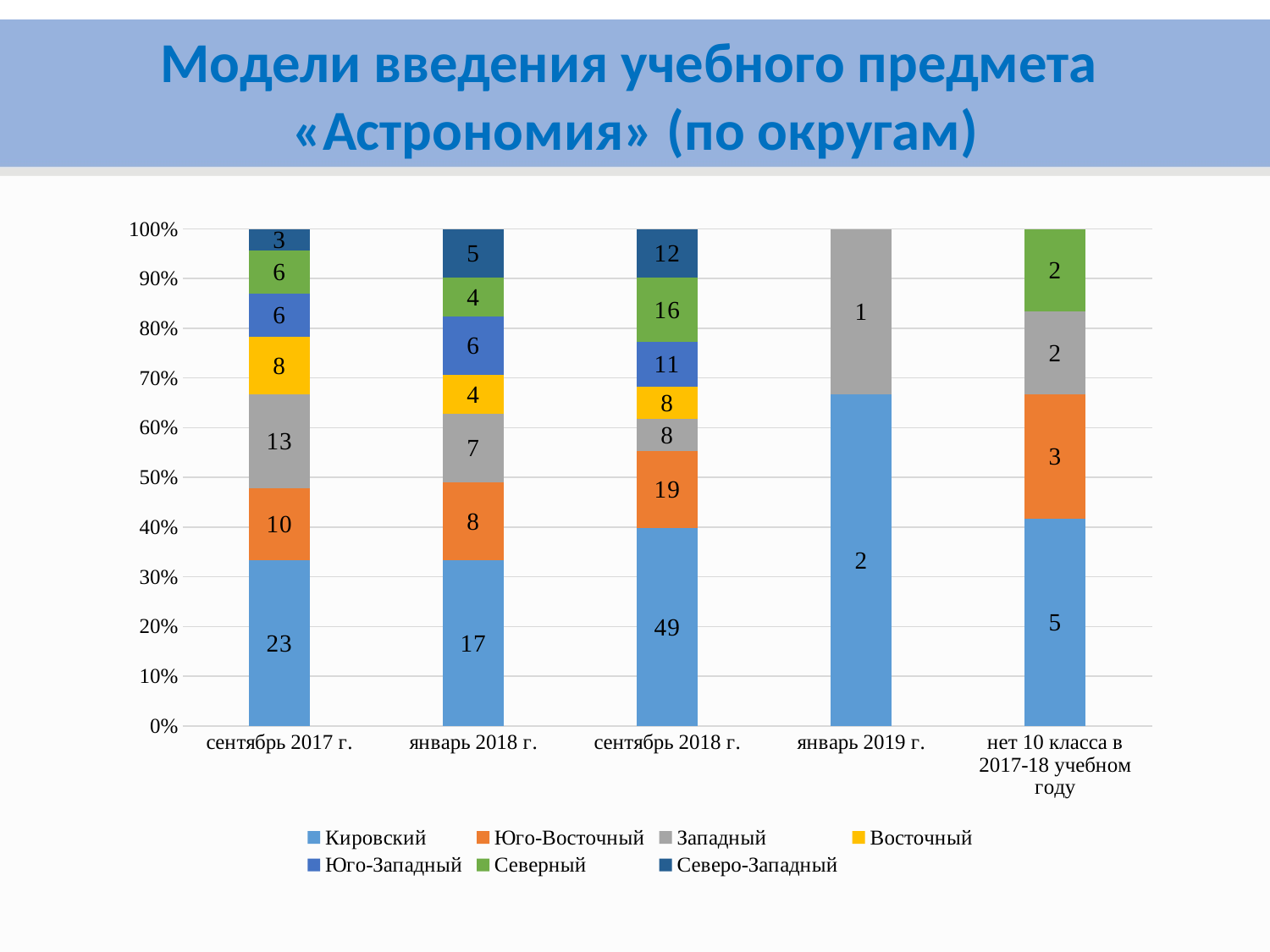
What is the value for Северо-Западный in январь 2018 г.? 5 What kind of chart is shown on the slide? stacked bar chart What is the value for Кировский in сентябрь 2018 г.? 49 What is the total of the stacked bar for сентябрь 2017 г.? 69 What is the total of the stacked bar for январь 2019 г.? 3 How many categories are shown along the x axis? 5 What is the value for Юго-Восточный in the category 'нет 10 класса в 2017-18 учебном году'? 3 Which series has the highest value in сентябрь 2018 г.? Кировский Which series has the lowest value in сентябрь 2017 г.? Северо-Западный How many series does the legend list? 7 What is the difference between the Кировский values for сентябрь 2018 г. and январь 2018 г.? 32 What is the value for Западный in сентябрь 2017 г.? 13